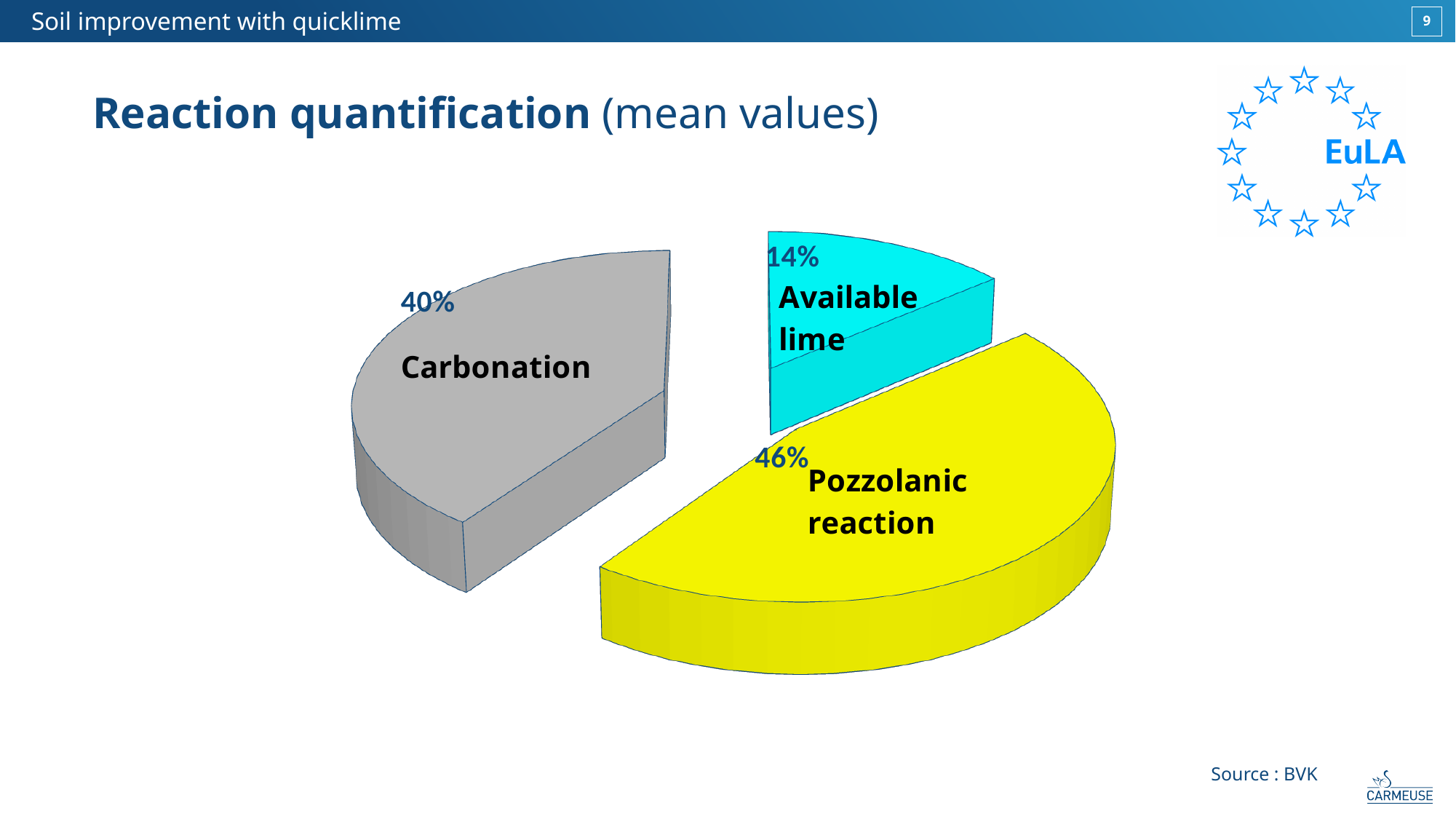
Which slice of the pie is the largest? Pozzolanic reaction What is the title of the chart on the slide? Reaction quantification (mean values) What share of the pie does Available lime represent? 14% How many slices does the pie chart have? 3 What is the difference in percentage points between Pozzolanic reaction and Carbonation? 6 Which slice of the pie is the smallest? Available lime Which is larger, the share for Carbonation or the share for Available lime? Carbonation What kind of chart is shown on the slide? pie chart What share of the pie does Pozzolanic reaction represent? 46% What share of the pie does Carbonation represent? 40% What is the difference in percentage points between Carbonation and Available lime? 26 What colour is the Pozzolanic reaction slice? yellow